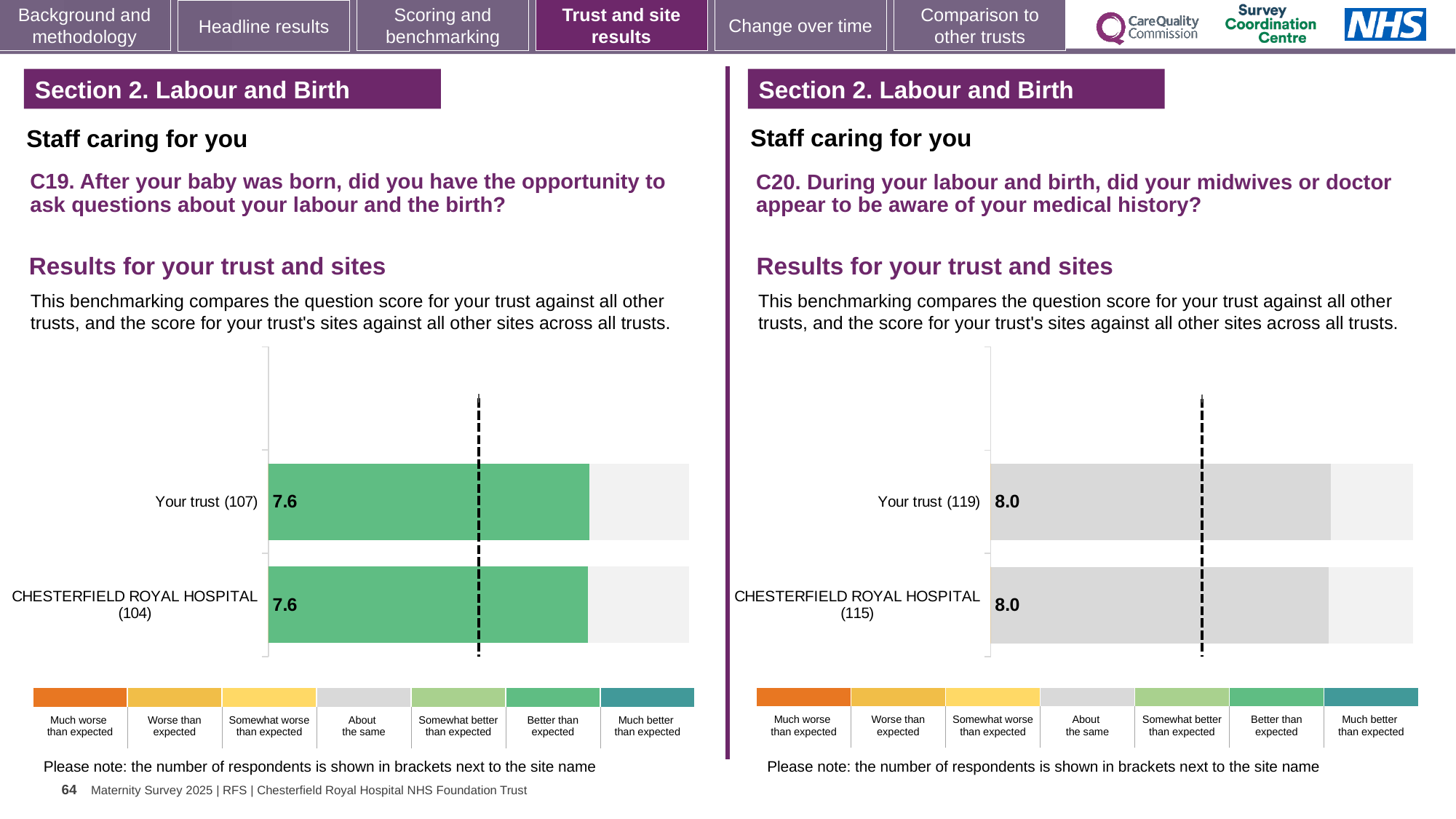
In the C19 chart on the left, what is the score for CHESTERFIELD ROYAL HOSPITAL (104)? 7.6 What kind of chart is used for the C19 results on the left? Bar chart How many bars are plotted in the C20 chart on the right? 2 Is the score for Your trust in the C20 chart on the right greater or less than the score for Your trust in the C19 chart on the left? greater In the C19 chart on the left, which benchmark category does the colour of the bars correspond to according to the key below the chart? Better than expected In the C20 chart on the right, what is the score for CHESTERFIELD ROYAL HOSPITAL (115)? 8.0 In the C19 chart on the left, what is the score for Your trust (107)? 7.6 In the C20 chart on the right, which benchmark category does the colour of the bars correspond to according to the key below the chart? About the same How many bars are plotted in the C19 chart on the left? 2 In the C20 chart on the right, what is the score for Your trust (119)? 8.0 In the C19 chart on the left, what is the difference between the score for Your trust and the score for CHESTERFIELD ROYAL HOSPITAL? 0.0